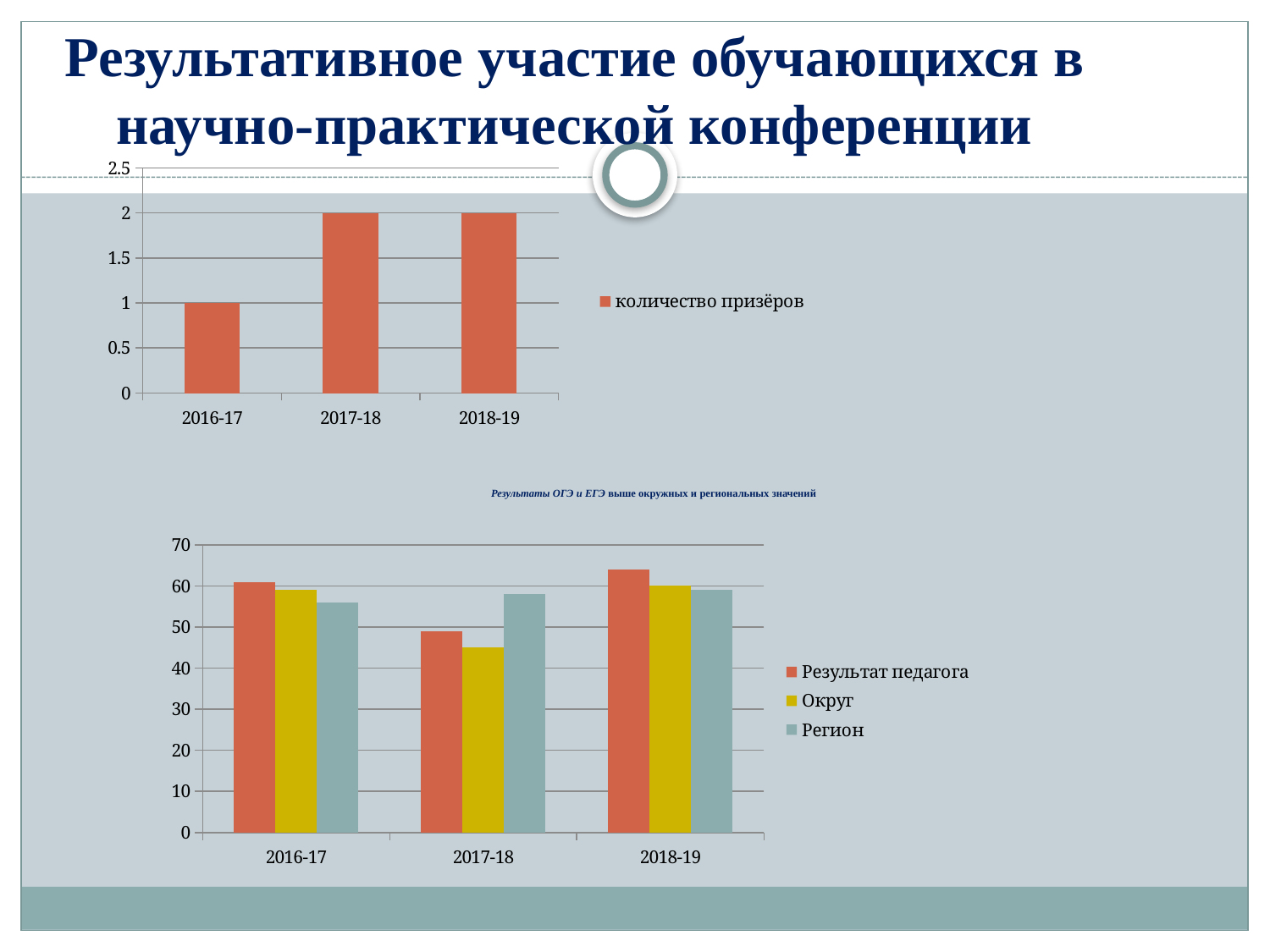
What kind of chart is the bottom chart? bar chart In the top chart, which category has the lowest value? 2016-17 In the top chart, what is the difference between the values for 2017-18 and 2016-17? 1 In the bottom chart, which is larger in 2017-18: Регион or Округ? Регион In the top chart, what is the value for 2016-17? 1 In the bottom chart, is the value for Округ in 2017-18 greater or less than 50? less In the top chart, what series name does the legend show? количество призёров In the bottom chart, is the value for Результат педагога in 2018-19 greater or less than 60? greater In the top chart, how many categories are shown on the x axis? 3 In the top chart, what is the value for 2017-18? 2 In the bottom chart, how many series does the legend list? 3 In the bottom chart, which series is shown in yellow? Округ